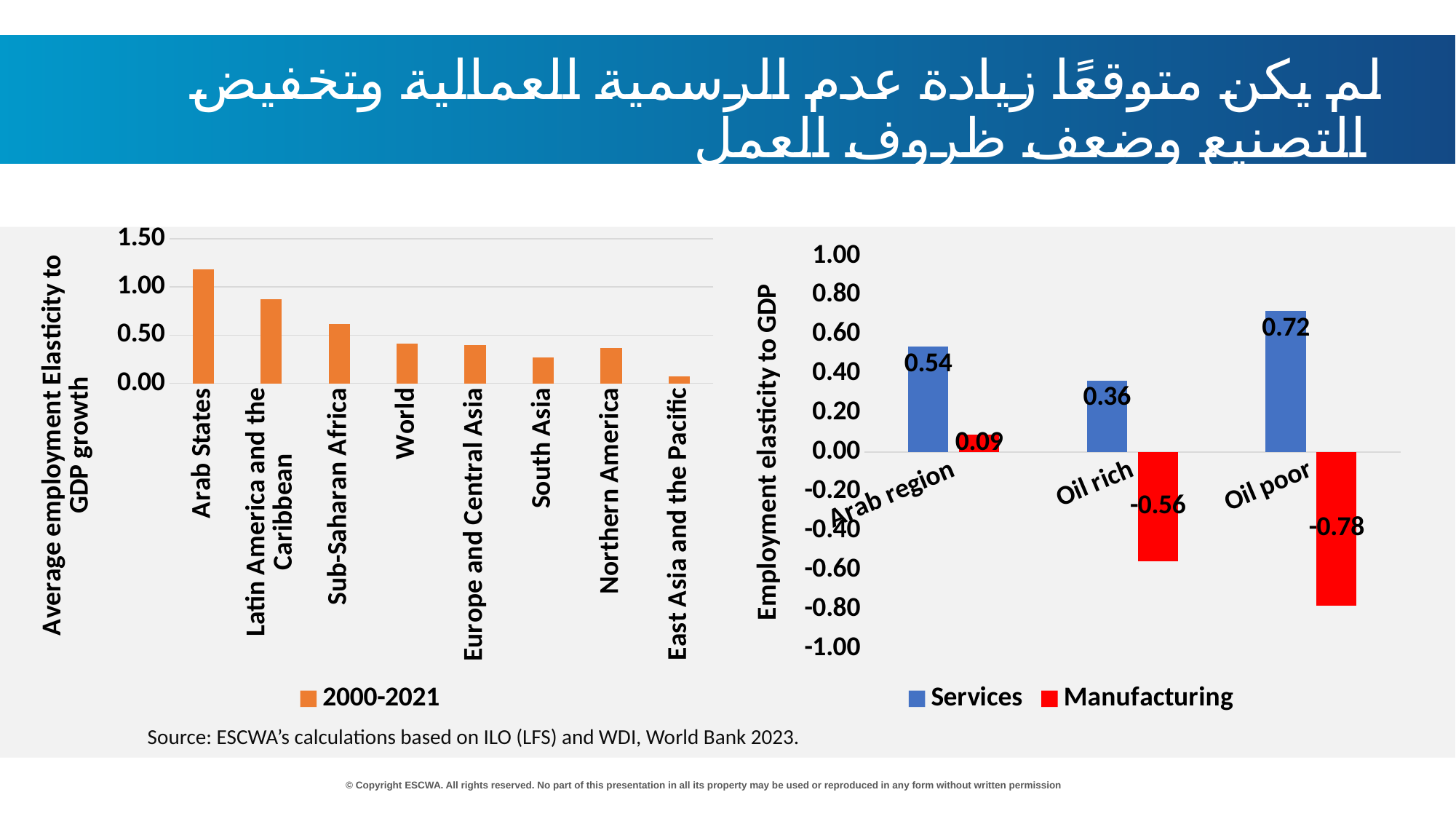
In the left chart (Average employment Elasticity to GDP growth), which region has the lowest bar? East Asia and the Pacific In the left chart (Average employment Elasticity to GDP growth), which region has the highest bar? Arab States In the right chart (Employment elasticity to GDP), what is the Manufacturing value for Oil rich? -0.56 In the left chart (Average employment Elasticity to GDP growth), is the value for South Asia greater or less than 0.50? less In the right chart (Employment elasticity to GDP), what is the Manufacturing value for the Arab region? 0.09 In the right chart (Employment elasticity to GDP), how many series does the legend list? 2 In the right chart (Employment elasticity to GDP), what is the difference between the Services values for Oil poor and Oil rich? 0.36 In the left chart (Average employment Elasticity to GDP growth), is the value for Arab States greater or less than 1.00? greater In the left chart (Average employment Elasticity to GDP growth), which is larger: Latin America and the Caribbean or Sub-Saharan Africa? Latin America and the Caribbean In the right chart (Employment elasticity to GDP), which category has the lowest Manufacturing value? Oil poor In the left chart (Average employment Elasticity to GDP growth), how many regions are plotted? 8 In the right chart (Employment elasticity to GDP), what is the Services value for Oil poor? 0.72